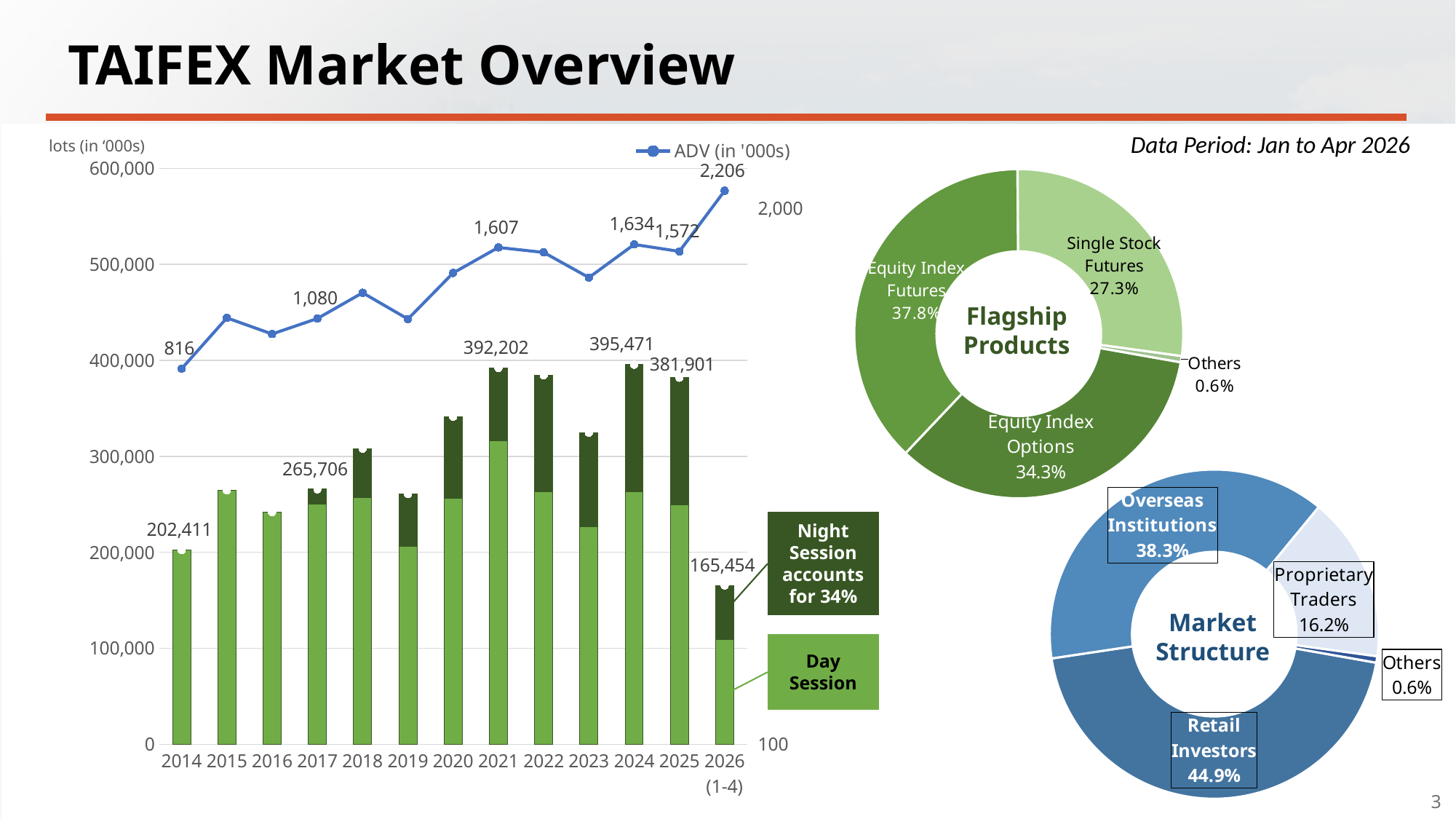
In the left bar chart, is the total lots value for 2020 greater or less than 300,000? greater In the left chart, what is the ADV (in '000s) value labelled for 2026 (1-4)? 2,206 What kind of chart is the left chart on the slide? A bar chart combined with a line chart In the left bar chart, what is the total lots value labelled for 2024? 395,471 How many years are shown on the x axis of the left bar chart? 13 According to the callout on the left chart, what percentage does the Night Session account for? 34% In the Market Structure donut chart, which category has the smallest share? Others In the Market Structure donut chart, what share do Retail Investors account for? 44.9% In the Flagship Products donut chart, what is the share of Single Stock Futures? 27.3% In the left bar chart, what is the difference between the total lots labelled for 2024 and 2025? 13,570 In the Flagship Products donut chart, which product has the largest share? Equity Index Futures In the left chart, which year has the higher ADV value, 2024 or 2025? 2024